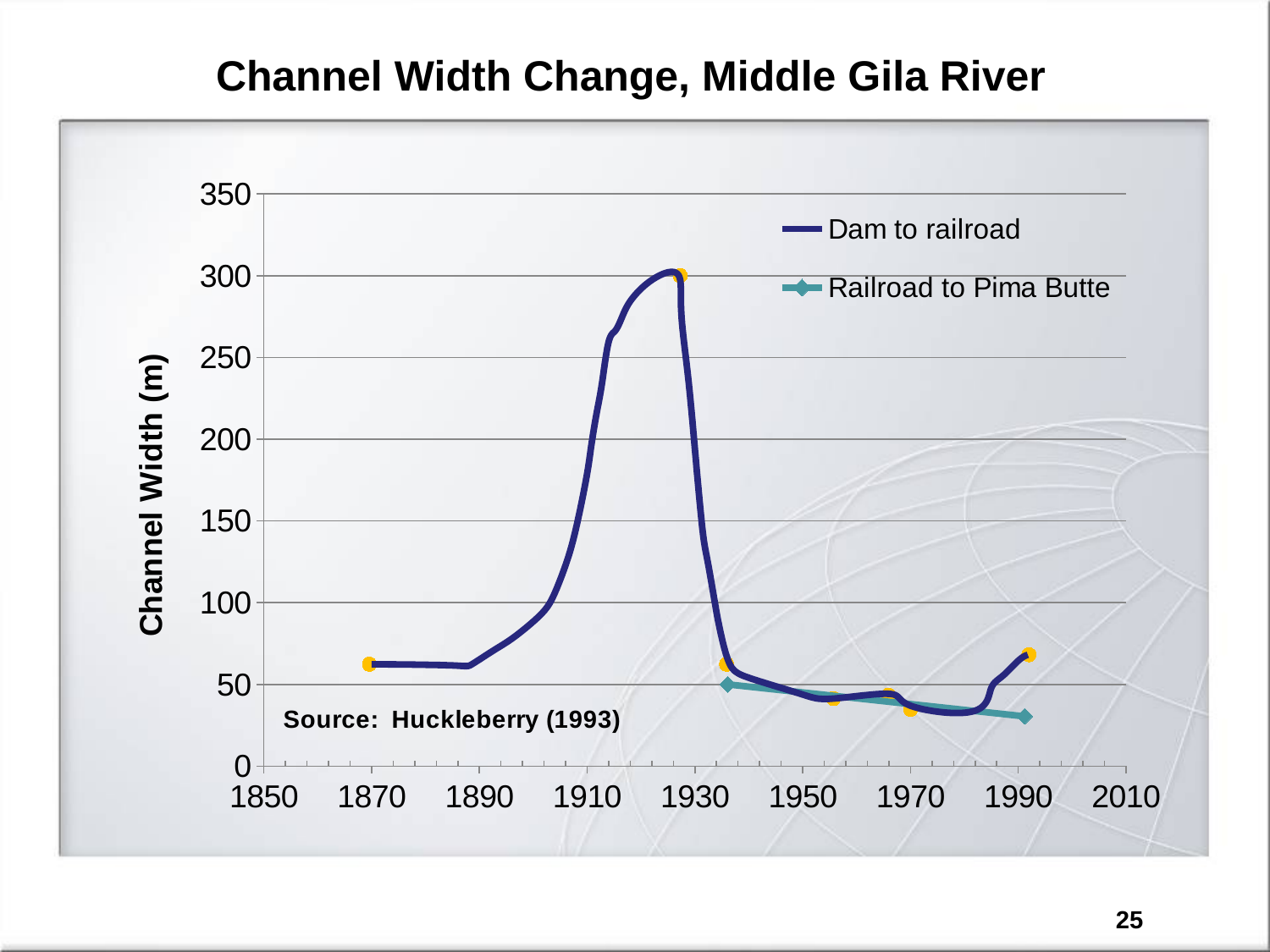
Around 1990, which series has the higher channel width, Dam to railroad or Railroad to Pima Butte? Dam to railroad Is the Dam to railroad value at 1870 greater or less than 50? greater How many data points are marked on the Railroad to Pima Butte series? 2 Does the Railroad to Pima Butte series rise or fall from its first point to its last point? Fall Is the Dam to railroad value around 1970 greater or less than 50? less Is the Railroad to Pima Butte value at its last point (around 1990) greater or less than 50? less What is the label of the vertical axis? Channel Width (m) How many series does the legend list? 2 What kind of chart is shown on the slide? Line chart What are the two series named in the legend? Dam to railroad; Railroad to Pima Butte